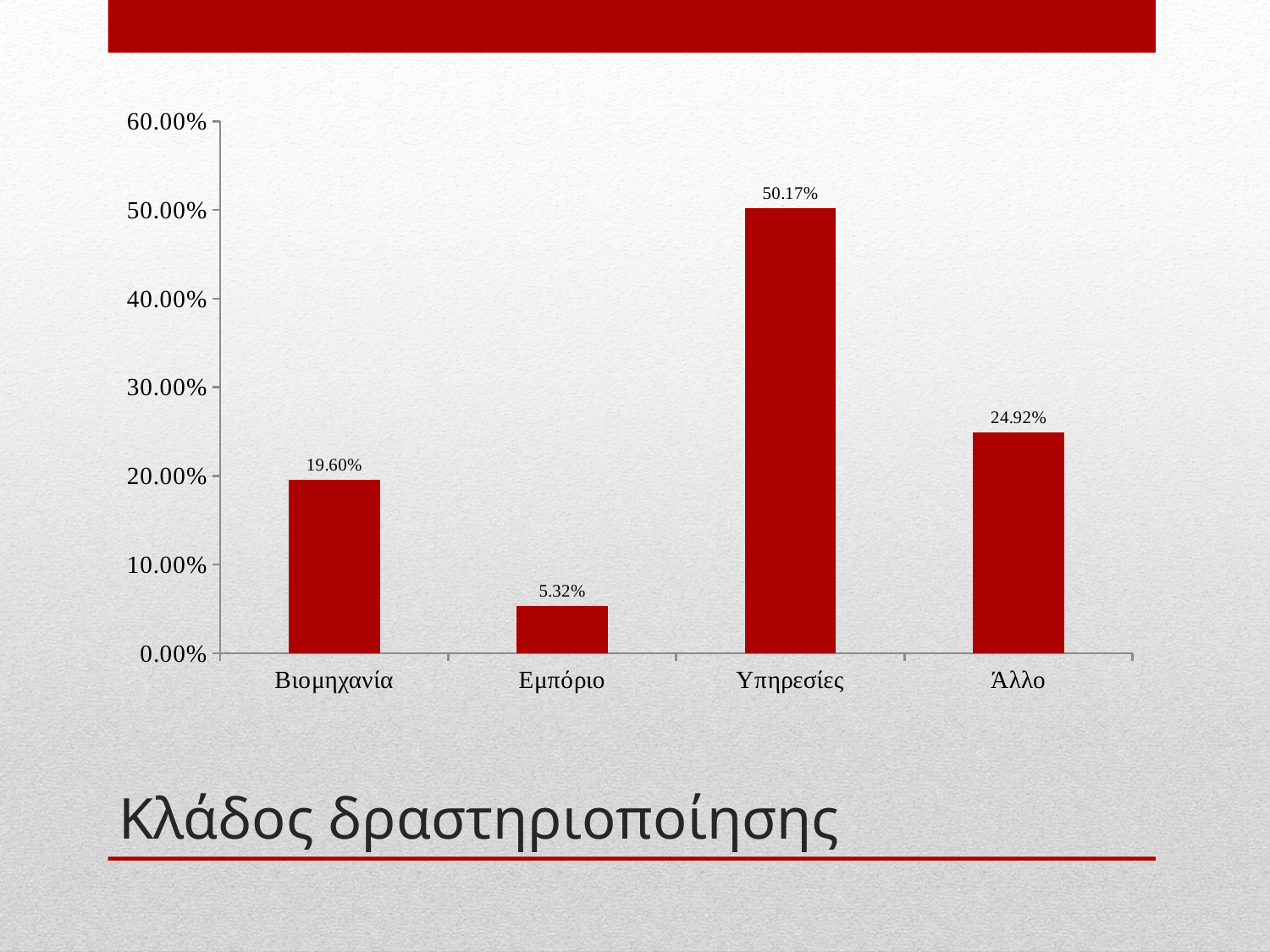
What is the value for Υπηρεσίες? 50.17% What is the difference between the values for Υπηρεσίες and Άλλο? 25.25% What kind of chart is shown on the slide? bar chart Which category has the lowest value? Εμπόριο What is the value for Βιομηχανία? 19.60% Is the value for Υπηρεσίες greater or less than 40.00%? greater What is the value for Εμπόριο? 5.32% What is the difference between the values for Βιομηχανία and Εμπόριο? 14.28% Which is larger, the value for Άλλο or the value for Βιομηχανία? Άλλο What is the value for Άλλο? 24.92% Which category has the highest value? Υπηρεσίες How many categories are shown on the x axis? 4